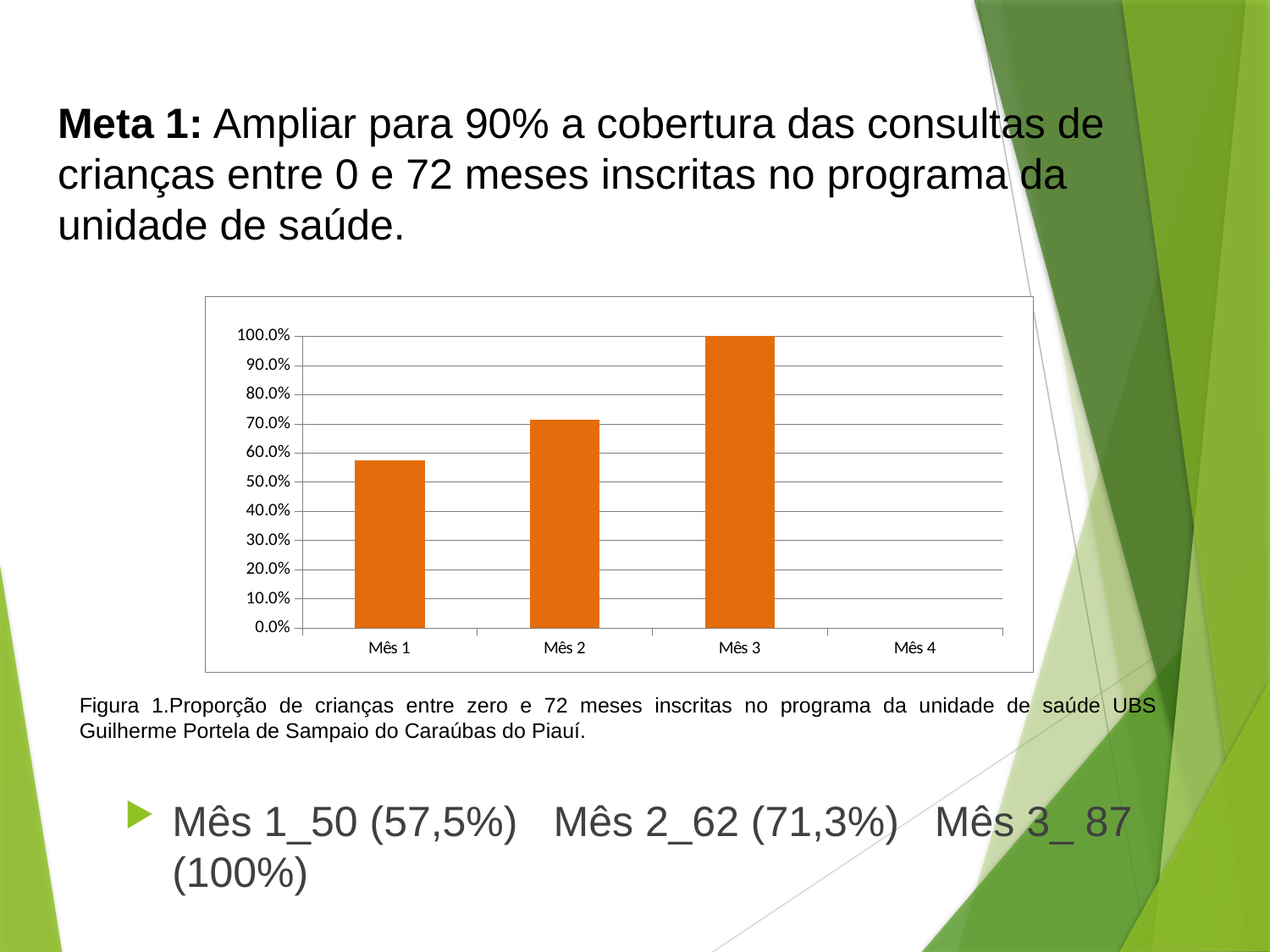
Is the value for Mês 1 greater or less than 60%? less What kind of chart is shown on the slide? bar chart What colour are the bars in the chart? orange Which month has the highest bar in the chart? Mês 3 Is the value for Mês 1 greater or less than 50%? greater How many categories are shown on the x axis of the chart? 4 Which is larger, the value for Mês 2 or the value for Mês 3? Mês 3 Do the bar values rise or fall from Mês 1 to Mês 3? rise Is the value for Mês 2 greater or less than 80%? less According to the text below the chart, what percentage is given for Mês 2? 71,3% According to the text below the chart, what percentage is given for Mês 3? 100% Among the months with a bar, which has the lowest value? Mês 1